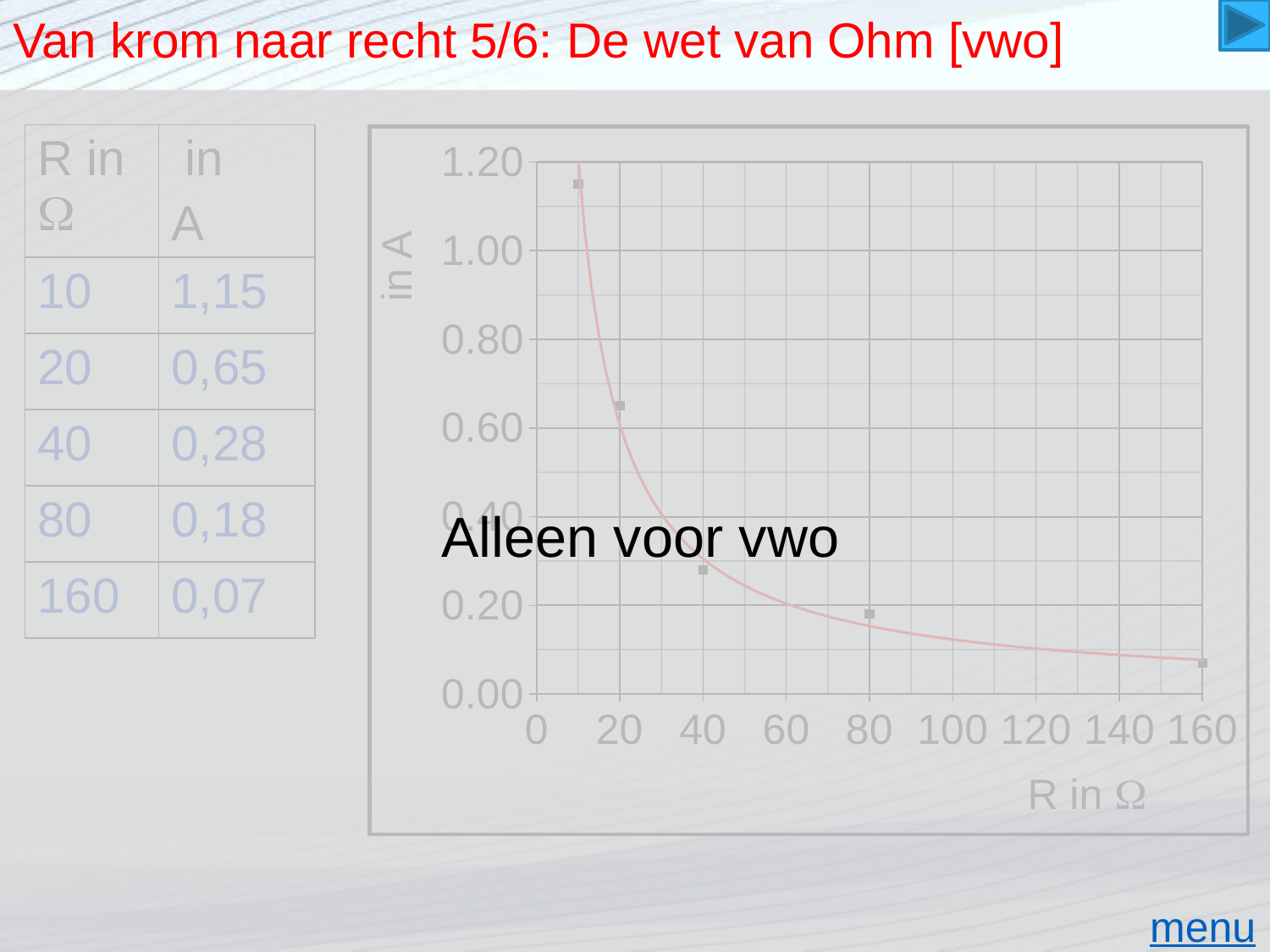
Is the plotted value at R = 80 greater or less than 0.20? less What kind of chart is shown on the slide? scatter chart with a smooth line Is the plotted value at R = 20 greater or less than 0.60? greater Do the plotted values rise or fall as R increases along the x axis? fall How many data points are plotted on the chart? 5 At which value of R is the plotted current lowest? 160 What is the current in A at R = 160 Ω? 0,07 What is the difference between the current at R = 10 Ω and at R = 160 Ω? 1,08 What is the current in A at R = 10 Ω? 1,15 What is the label on the x axis of the chart? R in Ω Which is larger: the current at R = 20 Ω or at R = 40 Ω? R = 20 Ω At which value of R is the plotted current highest? 10